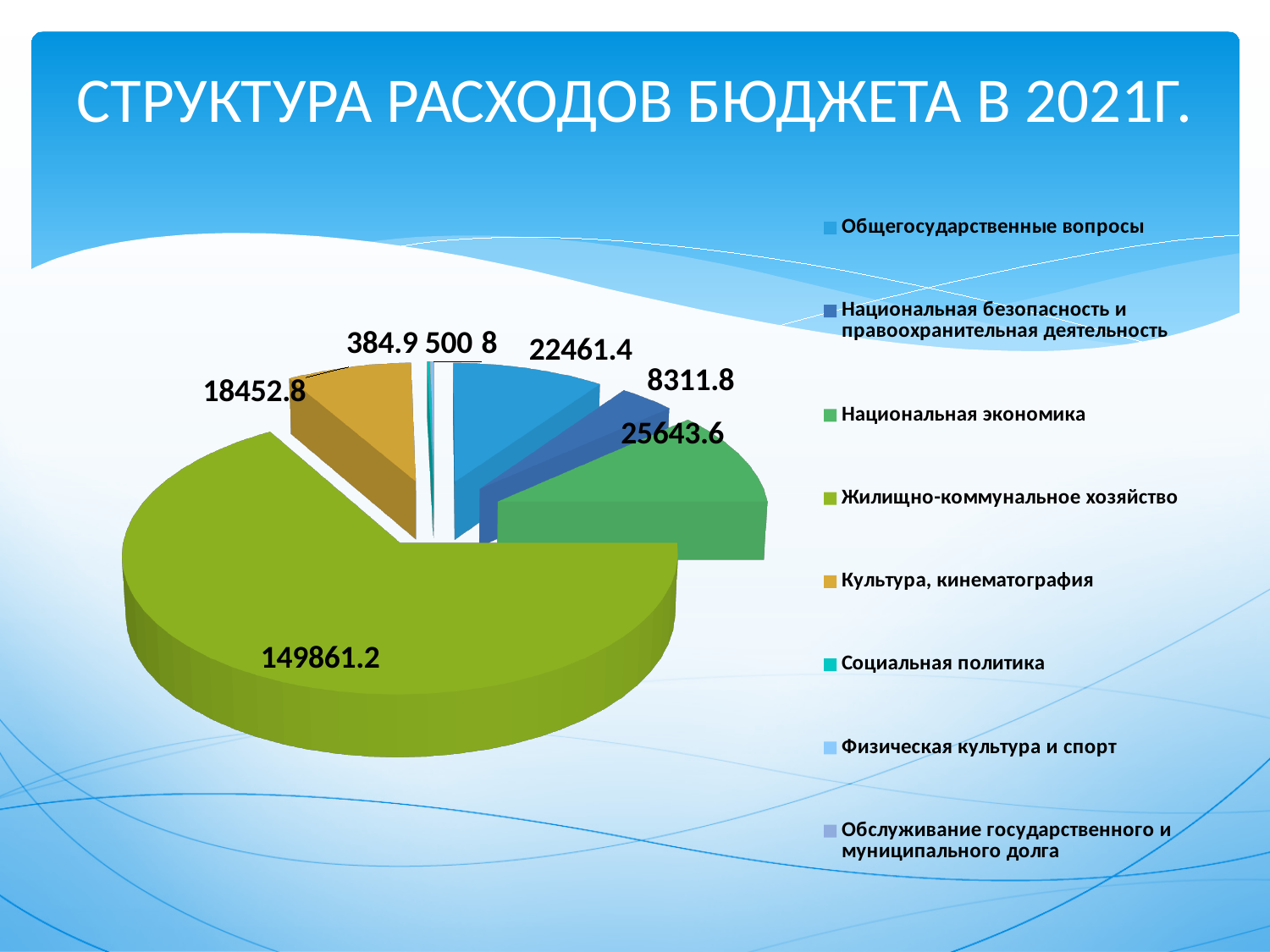
What kind of chart is shown on the slide? pie chart Which is larger: the value for Общегосударственные вопросы or the value for Культура, кинематография? Общегосударственные вопросы What is the value for Общегосударственные вопросы? 22461.4 What is the title of the slide? СТРУКТУРА РАСХОДОВ БЮДЖЕТА В 2021Г. What is the value for Жилищно-коммунальное хозяйство? 149861.2 What is the value for Национальная безопасность и правоохранительная деятельность? 8311.8 How many categories does the pie chart have? 8 What is the value for Национальная экономика? 25643.6 Which category has the smallest value? Обслуживание государственного и муниципального долга Which category has the largest slice of the pie? Жилищно-коммунальное хозяйство What is the value for Культура, кинематография? 18452.8 What is the difference between the values for Национальная экономика and Общегосударственные вопросы? 3182.2